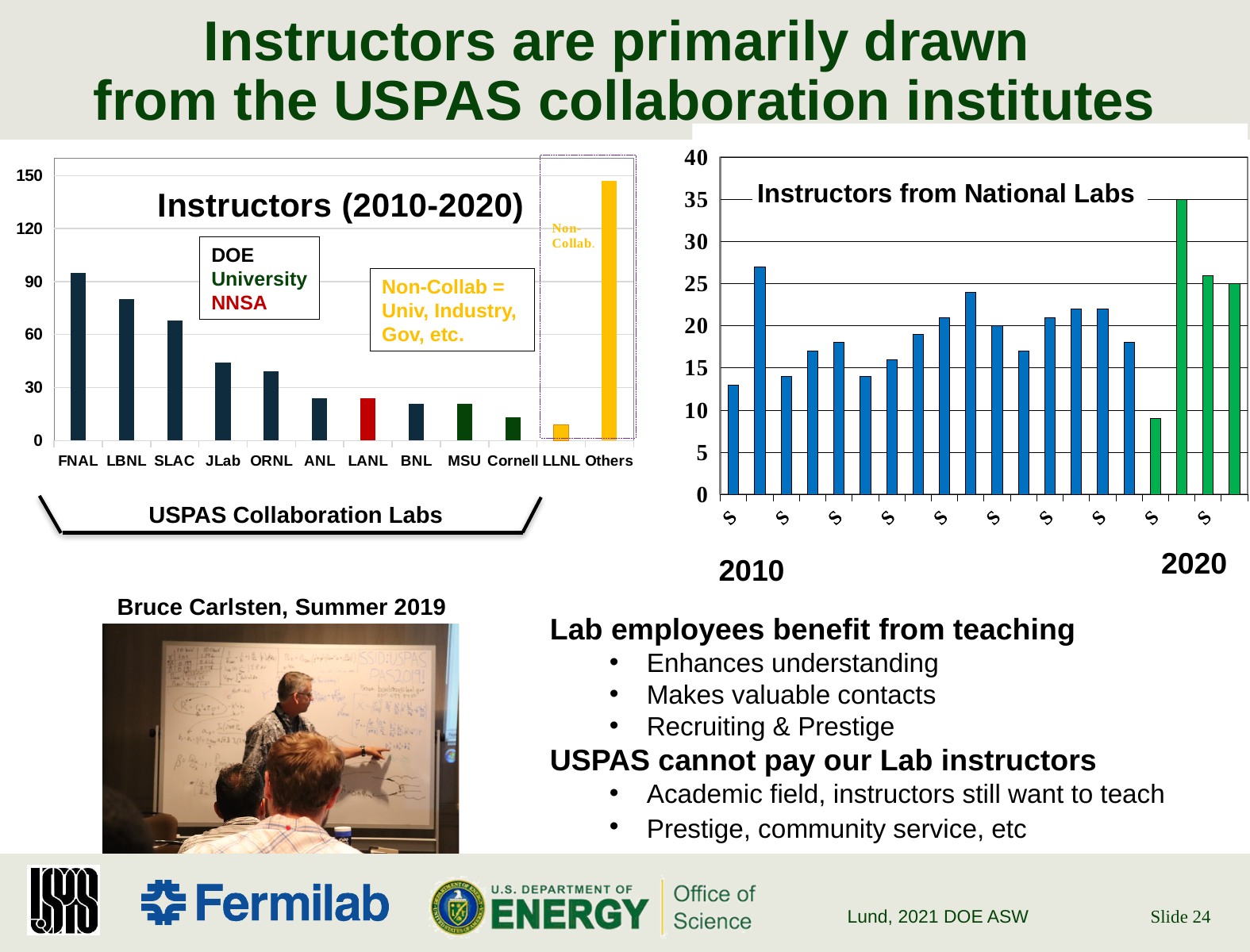
How many categories are shown on the x axis of the 'Instructors (2010-2020)' chart? 12 In the 'Instructors (2010-2020)' chart, which category has the highest bar? Others In the 'Instructors (2010-2020)' chart, is the value for FNAL greater or less than 60? greater In the 'Instructors (2010-2020)' chart, which is larger, the value for FNAL or the value for LBNL? FNAL What type of chart is the 'Instructors (2010-2020)' chart on the left? bar chart What type of chart is the 'Instructors from National Labs' chart on the right? bar chart In the 'Instructors (2010-2020)' chart, which is larger, the value for SLAC or the value for JLab? SLAC In the 'Instructors (2010-2020)' chart, what colour is the LANL bar? red In the 'Instructors (2010-2020)' chart, is the value for Others greater or less than 120? greater In the 'Instructors (2010-2020)' chart, is the value for Cornell greater or less than 30? less In the 'Instructors (2010-2020)' chart, which category has the lowest bar? LLNL